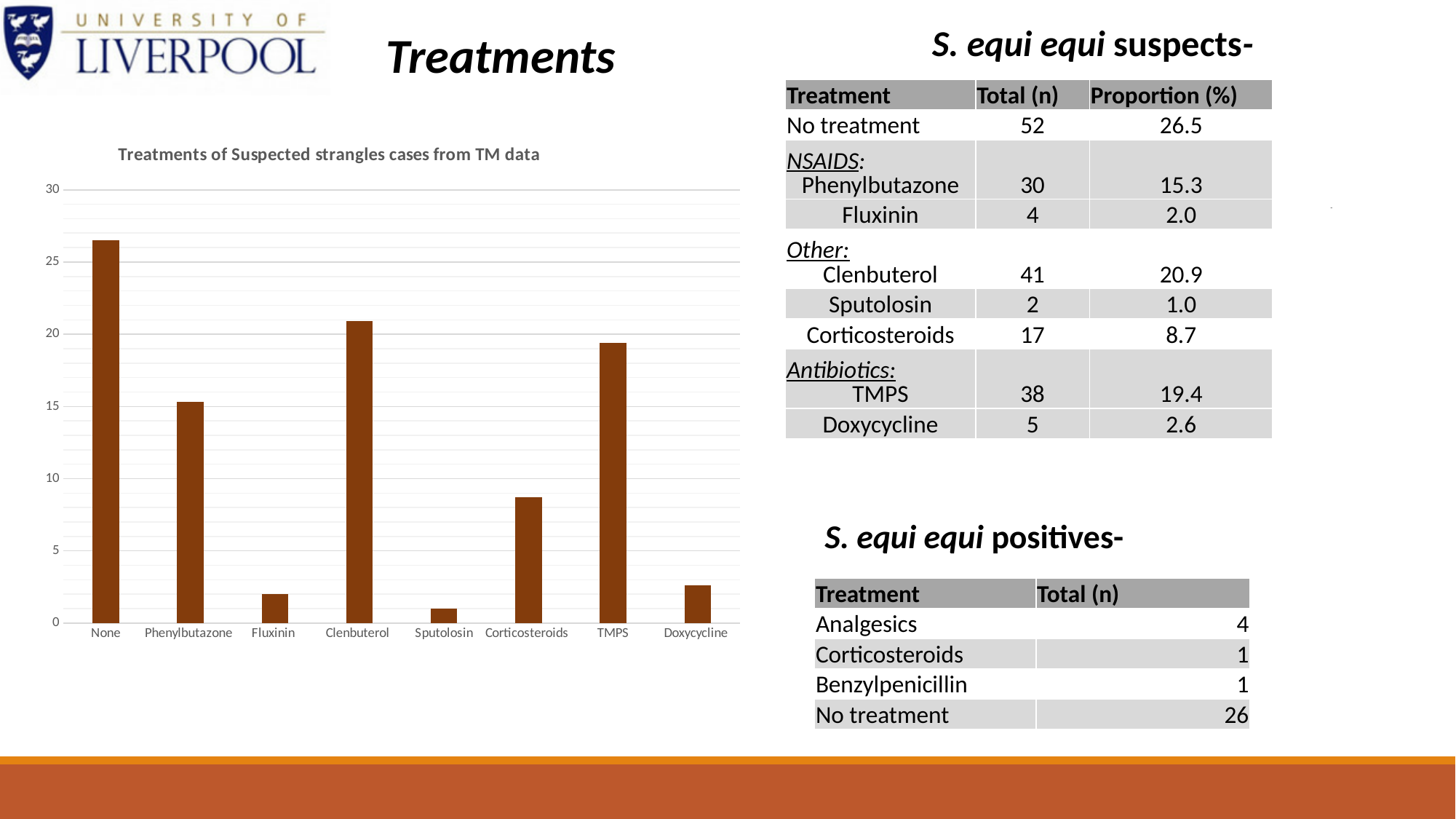
Is the value for None greater or less than 25? greater Which is larger in the chart, the bar for None or the bar for Clenbuterol? None Which treatment category has the highest bar in the chart? None Which treatment category has the lowest bar in the chart? Sputolosin Is the value for Fluxinin greater or less than 5? less What kind of chart is shown on the slide? bar chart Which is larger in the chart, the bar for Phenylbutazone or the bar for Corticosteroids? Phenylbutazone Is the value for TMPS greater or less than 20? less How many treatment categories are shown on the x axis of the chart? 8 What is the title of the chart? Treatments of Suspected strangles cases from TM data